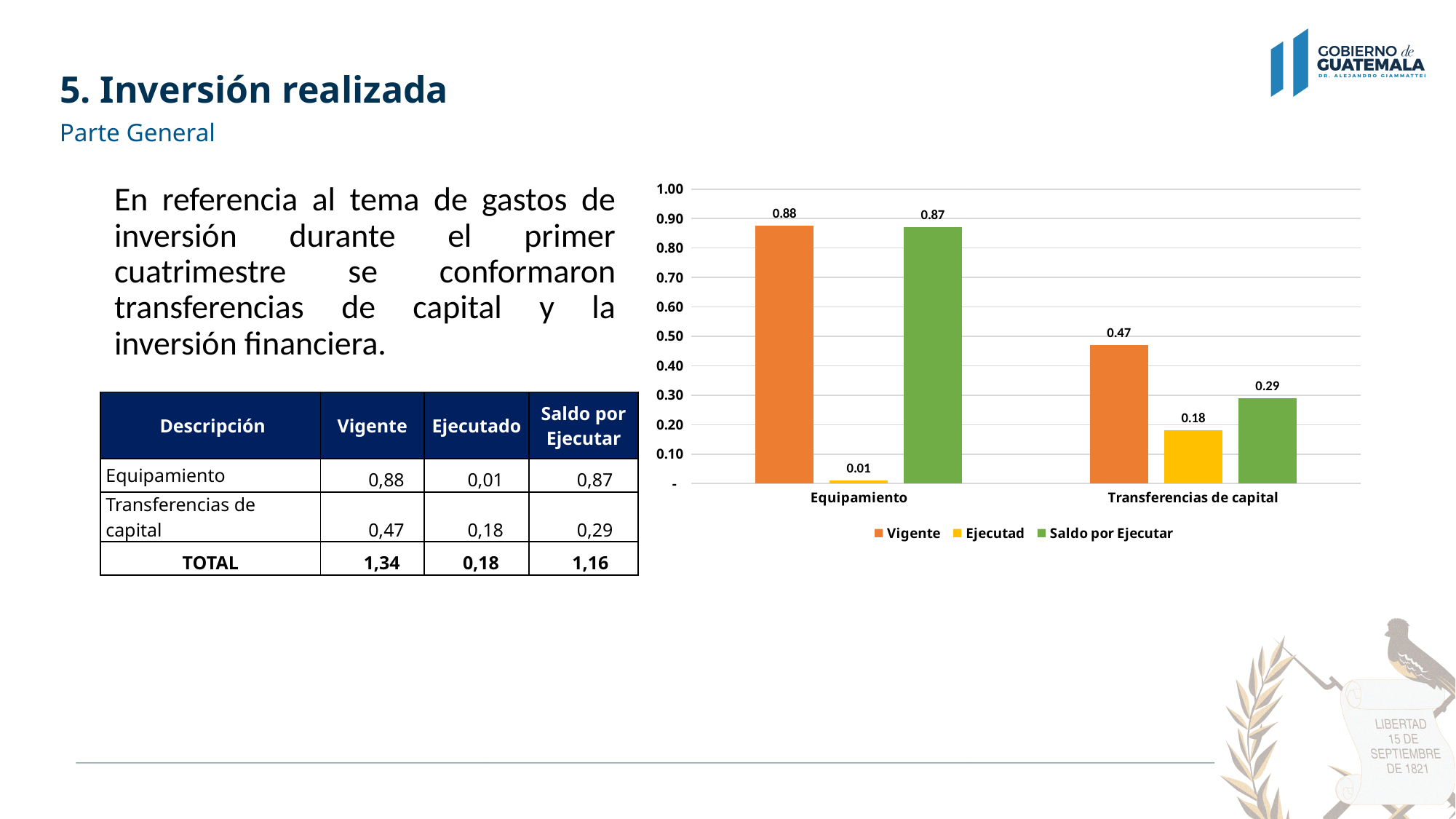
Is the Vigente value for Equipamiento greater or less than 0.80? greater How many series does the chart legend list? 3 What is the Ejecutado value for Transferencias de capital in the chart? 0.18 What is the Vigente value for Equipamiento in the chart? 0.88 What type of chart is shown on the slide? Bar chart Which category has the higher Vigente value in the chart? Equipamiento What is the Vigente value for Transferencias de capital in the chart? 0.47 How many categories are shown on the x axis of the chart? 2 Which category has the lower Ejecutado value in the chart? Equipamiento Is the Saldo por Ejecutar value for Transferencias de capital larger than the Ejecutado value for Transferencias de capital? Yes What is the difference between the Vigente and Saldo por Ejecutar values for Transferencias de capital? 0.18 What is the Saldo por Ejecutar value for Equipamiento in the chart? 0.87